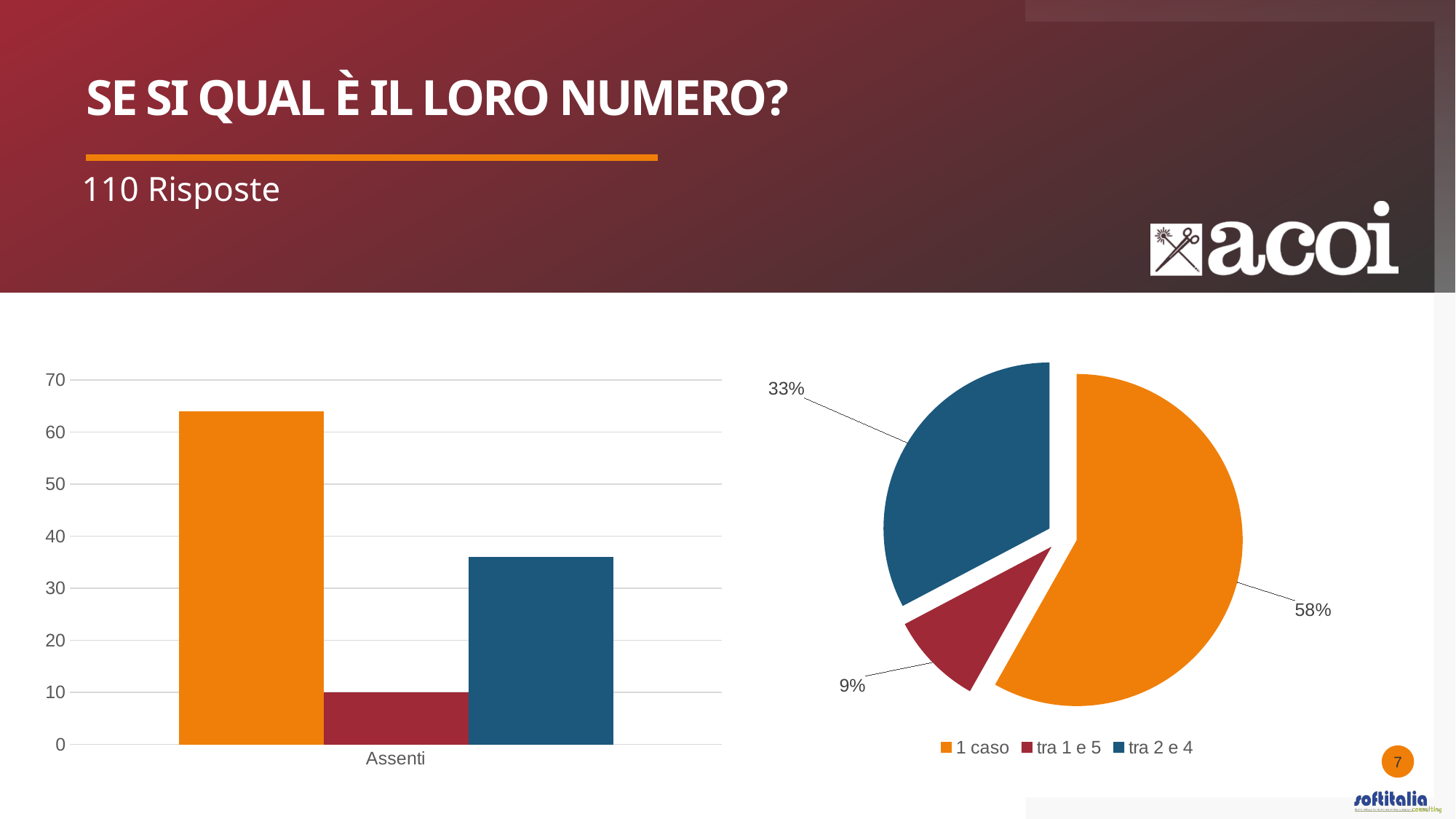
What kind of chart is shown on the left of the slide? bar chart In the bar chart on the left, is the value of the orange bar greater or less than 60? greater How many entries does the legend of the pie chart on the right list? 3 In the pie chart on the right, which category has the smallest slice? tra 1 e 5 In the bar chart on the left, which coloured bar is the tallest? the orange bar In the pie chart on the right, what share is labelled for the "tra 1 e 5" slice? 9% In the pie chart on the right, which category has the largest slice? 1 caso In the pie chart on the right, what is the difference in percentage points between the "1 caso" slice and the "tra 2 e 4" slice? 25% In the pie chart on the right, what share is labelled for the "1 caso" slice? 58% What is the category label shown on the x axis of the bar chart on the left? Assenti In the bar chart on the left, is the value of the blue bar greater or less than 40? less In the pie chart on the right, what share is labelled for the "tra 2 e 4" slice? 33%